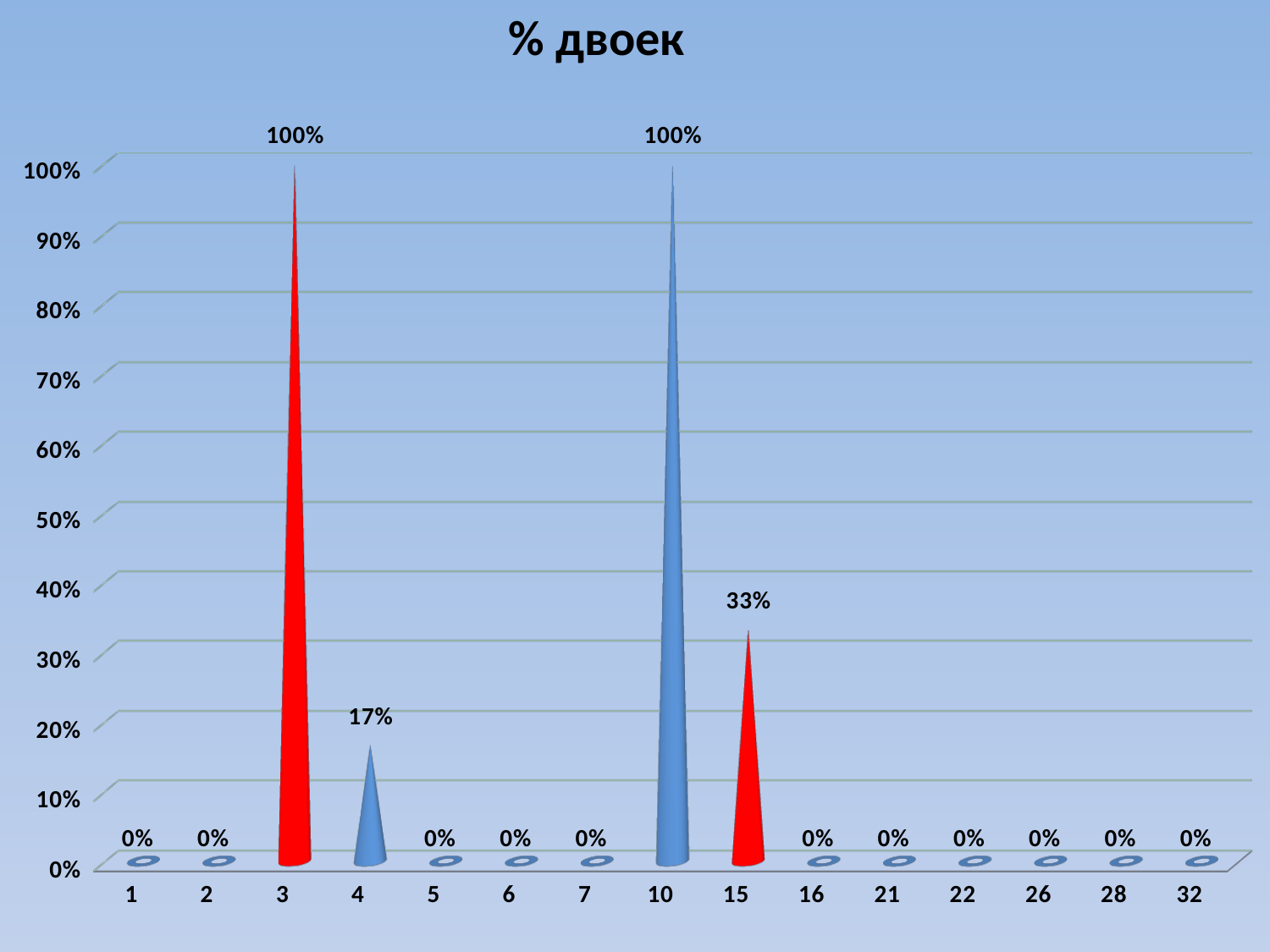
What type of chart is shown on the slide? bar chart What is the difference between the values for category 10 and category 15? 67% What is the value for category 15? 33% What is the title of the chart? % двоек What is the difference between the values for category 15 and category 4? 16% Which is larger, the value for category 4 or the value for category 15? category 15 Which categories have the highest value? 3 and 10 What is the value for category 3? 100% How many categories are shown on the x axis? 15 What is the value for category 16? 0% Which categories are shown with red bars? 3 and 15 What is the value for category 4? 17%